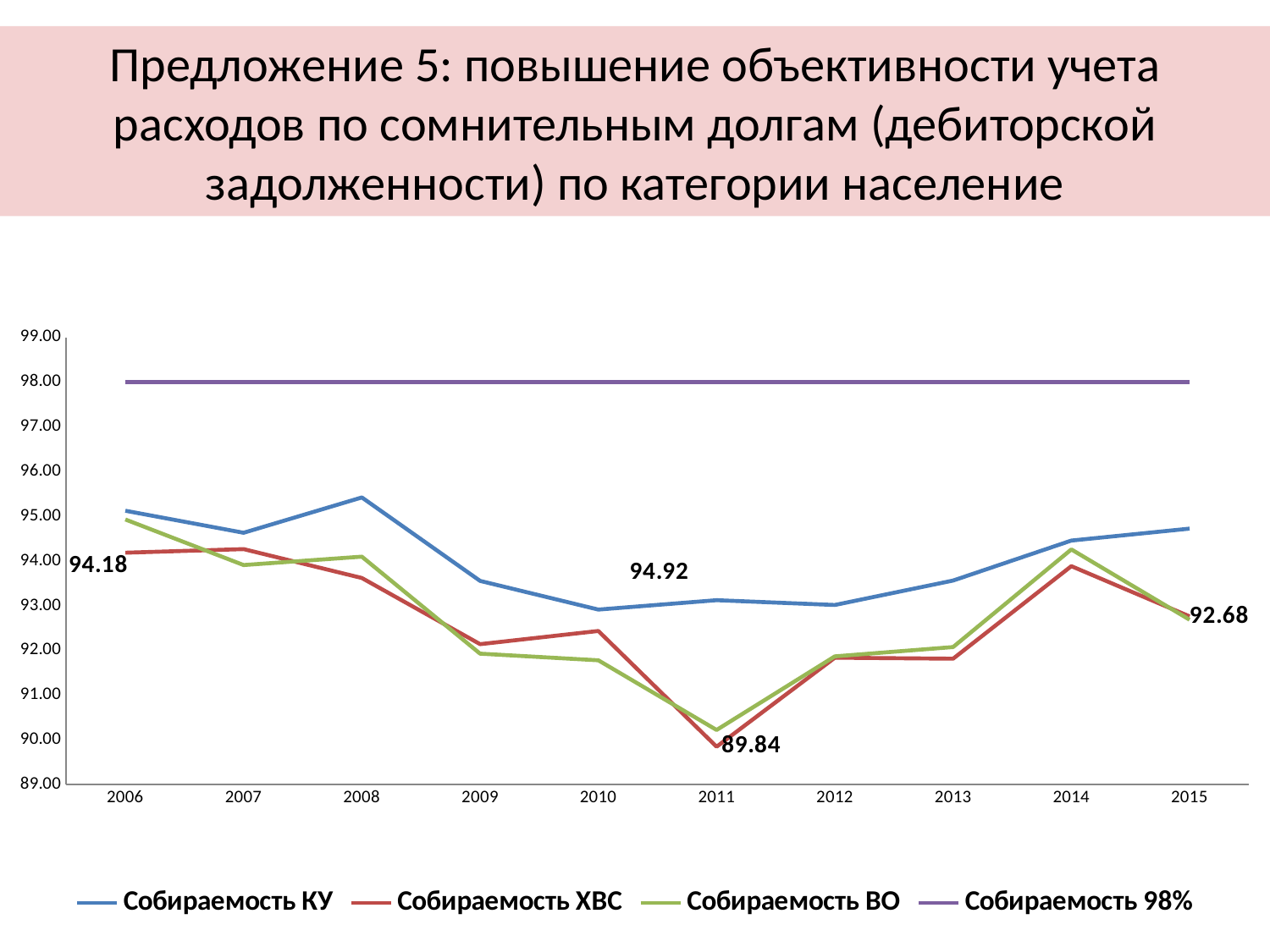
How many years are shown on the x axis? 10 Which is larger in 2006: Собираемость КУ or Собираемость ХВС? Собираемость КУ Is the value of Собираемость ВО in 2011 greater or less than 91.00? less What kind of chart is shown on the slide? line chart What is the difference between Собираемость ХВС in 2006 and in 2011? 4.34 What is the value of Собираемость ХВС in 2011? 89.84 How many series does the legend list? 4 Which legend entry corresponds to the flat purple line near the top of the chart? Собираемость 98% Is the value of Собираемость КУ in 2008 greater or less than 95.00? greater In which year is Собираемость ХВС at its lowest? 2011 What is the value of Собираемость ХВС in 2006? 94.18